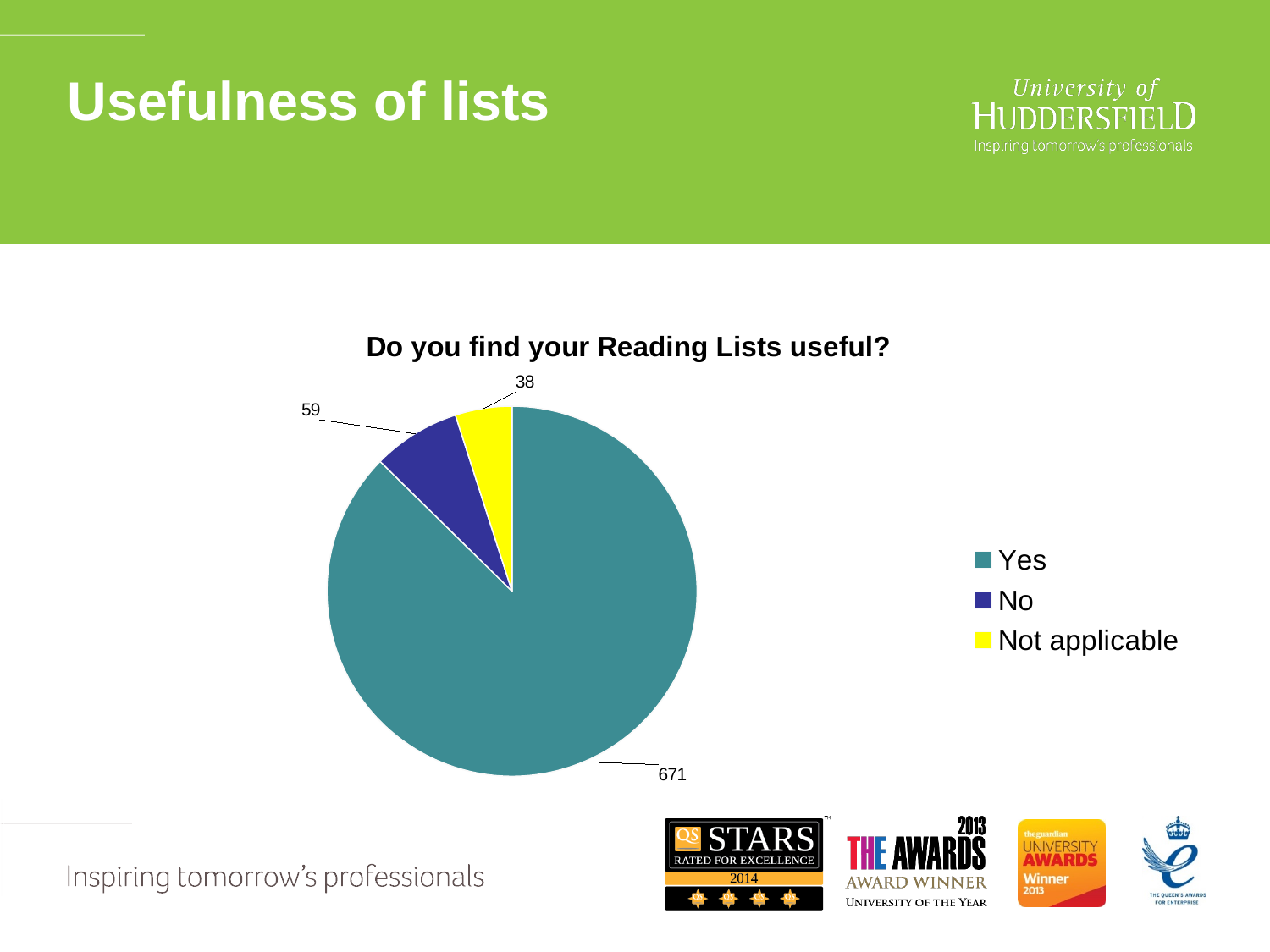
How many respondents answered "Yes"? 671 What kind of chart is shown on the slide? pie chart What is the title of the chart? Do you find your Reading Lists useful? What is the total of all three slices? 768 Which category has the smallest slice of the pie? Not applicable Which is larger, the value for "No" or the value for "Not applicable"? No How many respondents answered "No"? 59 How many categories does the pie chart have? 3 What is the difference between the "Yes" and "No" values? 612 What is the value for "Not applicable"? 38 Which category has the largest slice of the pie? Yes What is the difference between the "No" and "Not applicable" values? 21